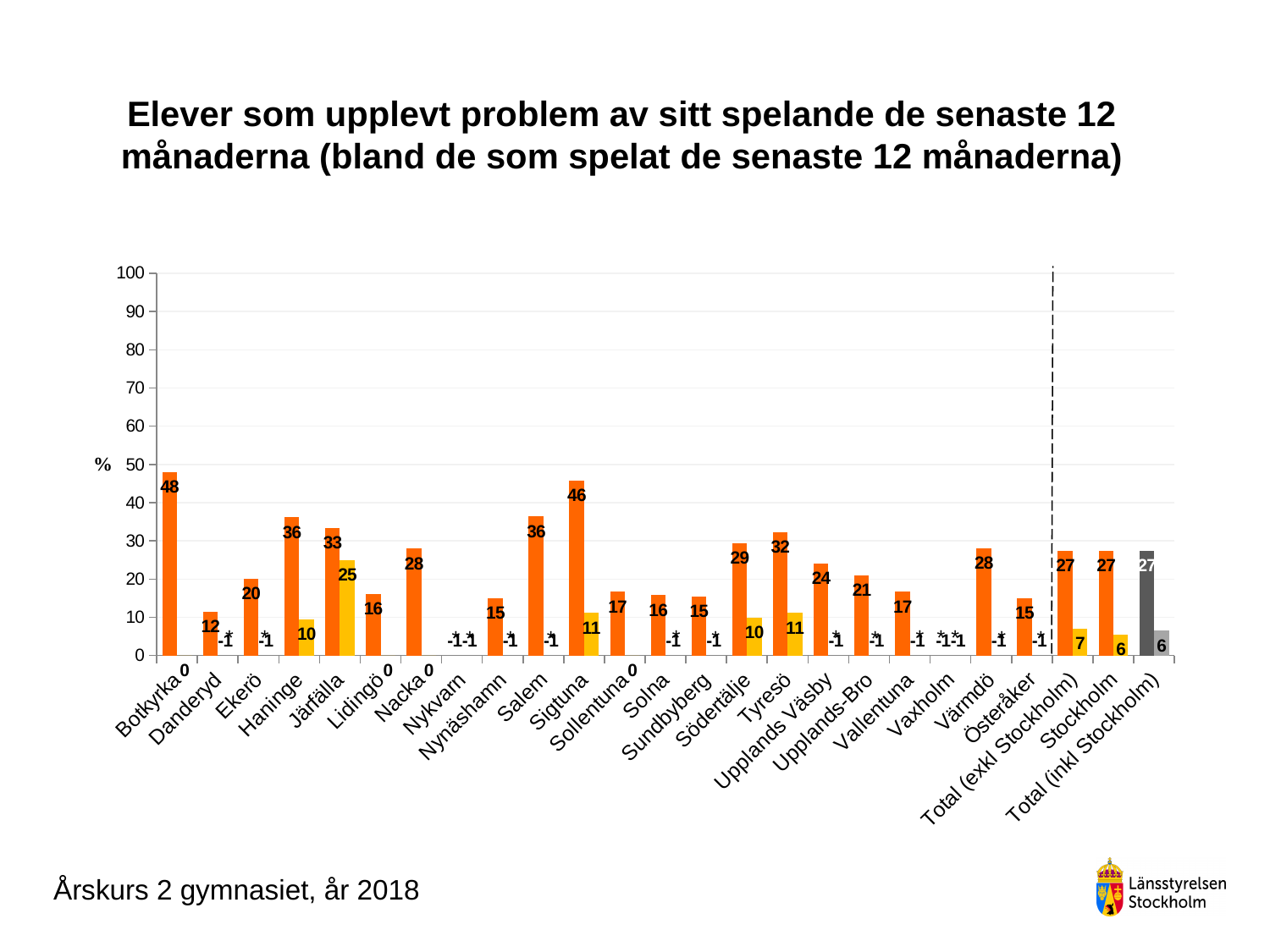
What is the value of the grey bar for Total (inkl Stockholm)? 27 What is the value of the yellow bar for Järfälla? 25 Is the orange bar value for Nacka greater or less than 30? less What is the value of the orange bar for Botkyrka? 48 What is the value of the yellow bar for Stockholm? 6 Which has the larger orange bar value, Tyresö or Södertälje? Tyresö Which municipality has the highest orange bar? Botkyrka What kind of chart is shown on the slide? Bar chart What is the label on the vertical axis? % What is the value of the yellow bar for Haninge? 10 What is the difference between the orange bar values for Botkyrka and Sigtuna? 2 What is the value of the orange bar for Sigtuna? 46